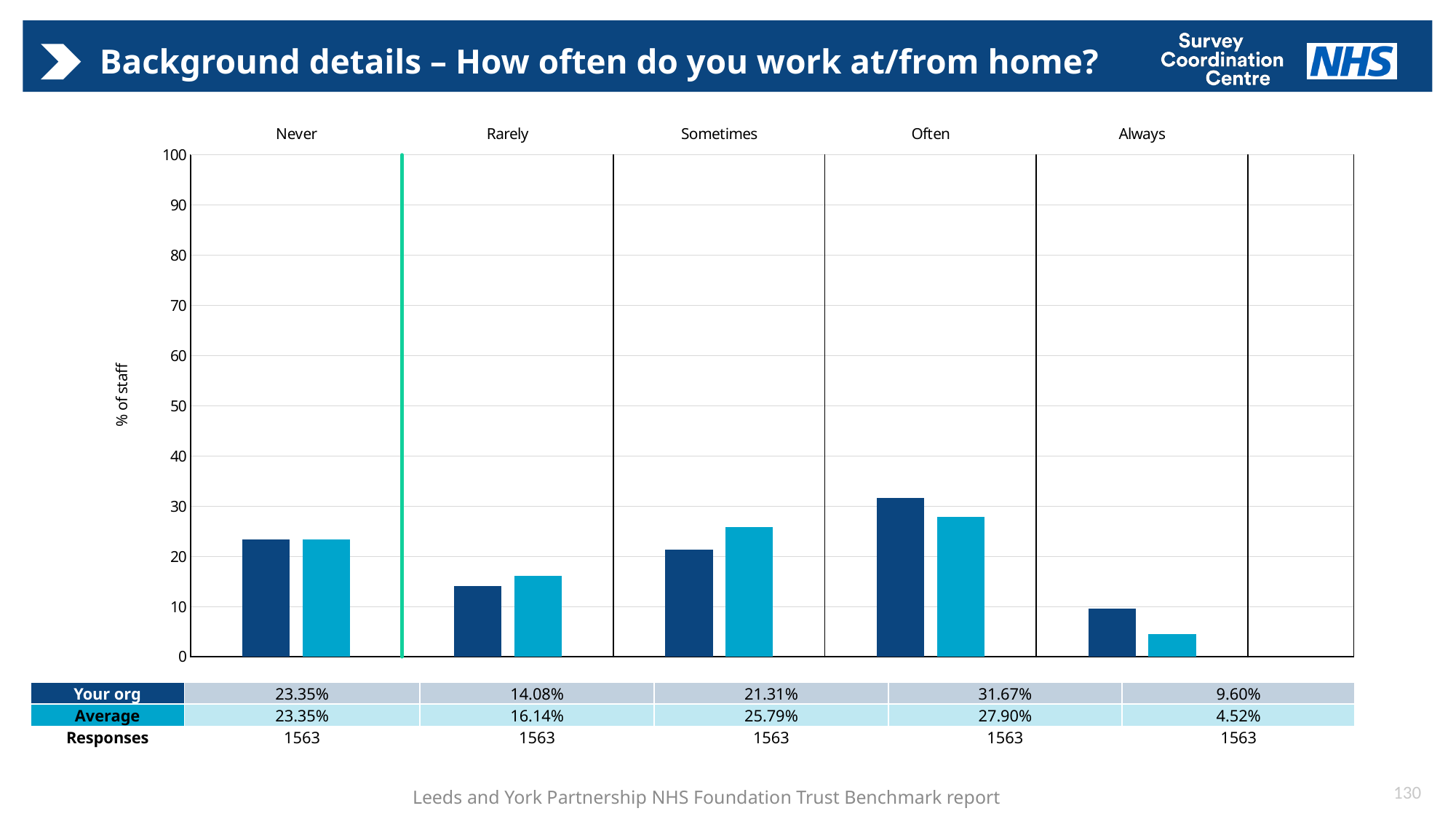
What kind of chart is shown on the slide? bar chart What is the difference between the 'Your org' and Average values for Often? 3.77% What is the number of responses shown for Never? 1563 What is the Average value for Sometimes? 25.79% Which category has the lowest Average value? Always Is the 'Your org' value for Rarely greater or less than 20? less How many categories are shown on the x axis? 5 Which is larger for Sometimes: the 'Your org' value or the Average value? Average What is the 'Your org' value for Always? 9.60% What is the 'Your org' value for Often? 31.67% Which category has the highest 'Your org' value? Often How many series does the chart show? 2